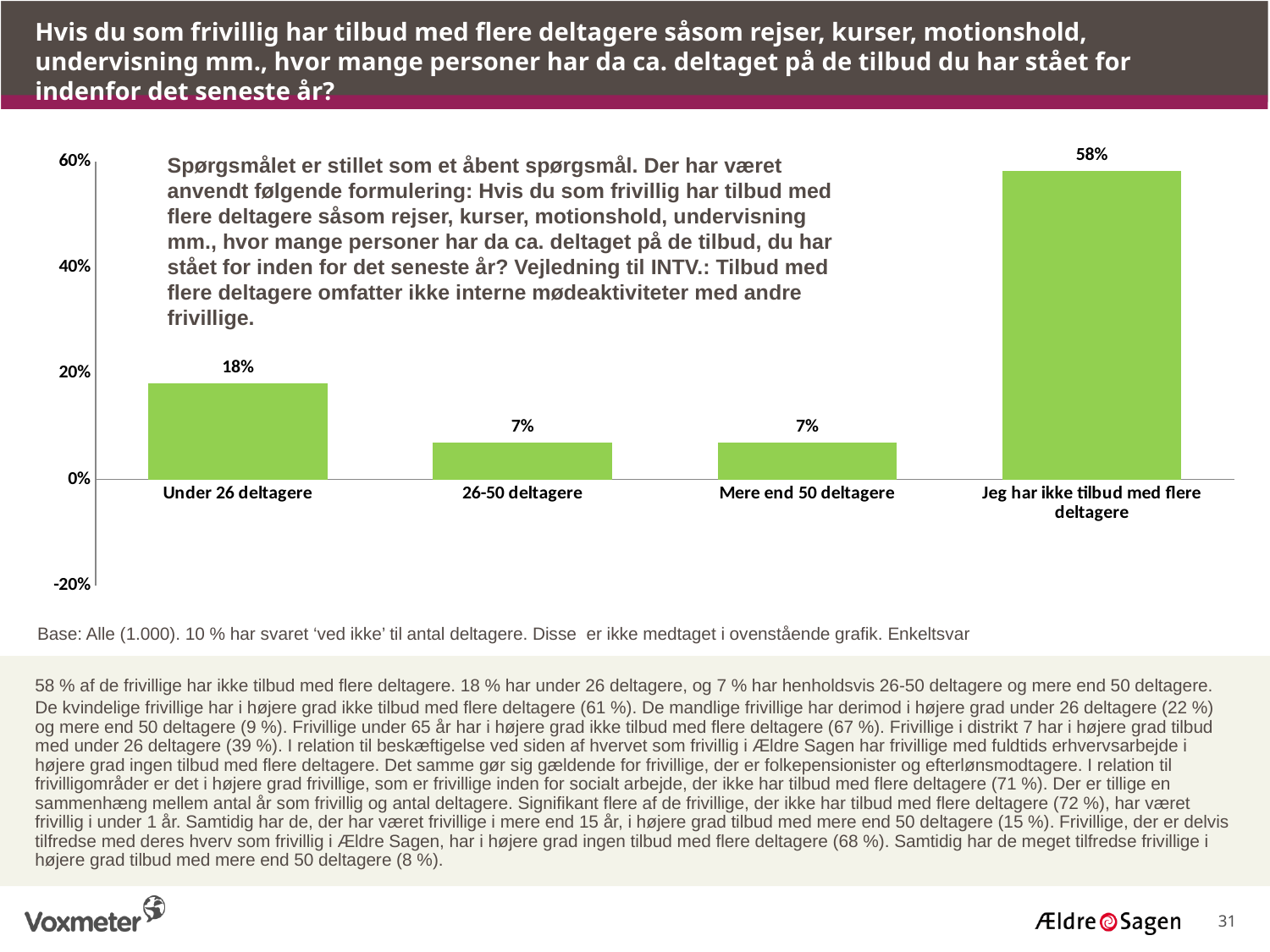
What is the difference between 'Under 26 deltagere' and '26-50 deltagere'? 11% Which category has the highest value? Jeg har ikke tilbud med flere deltagere What colour are the bars in the chart? green Which is larger, 'Under 26 deltagere' or 'Mere end 50 deltagere'? Under 26 deltagere What is the value for 'Mere end 50 deltagere'? 7% Is the value for 'Jeg har ikke tilbud med flere deltagere' greater or less than 40%? greater How many categories are shown on the x axis? 4 What kind of chart is shown on the slide? bar chart What is the difference between 'Jeg har ikke tilbud med flere deltagere' and 'Under 26 deltagere'? 40% What is the value for 'Under 26 deltagere'? 18% What is the value for '26-50 deltagere'? 7% What is the value for 'Jeg har ikke tilbud med flere deltagere'? 58%